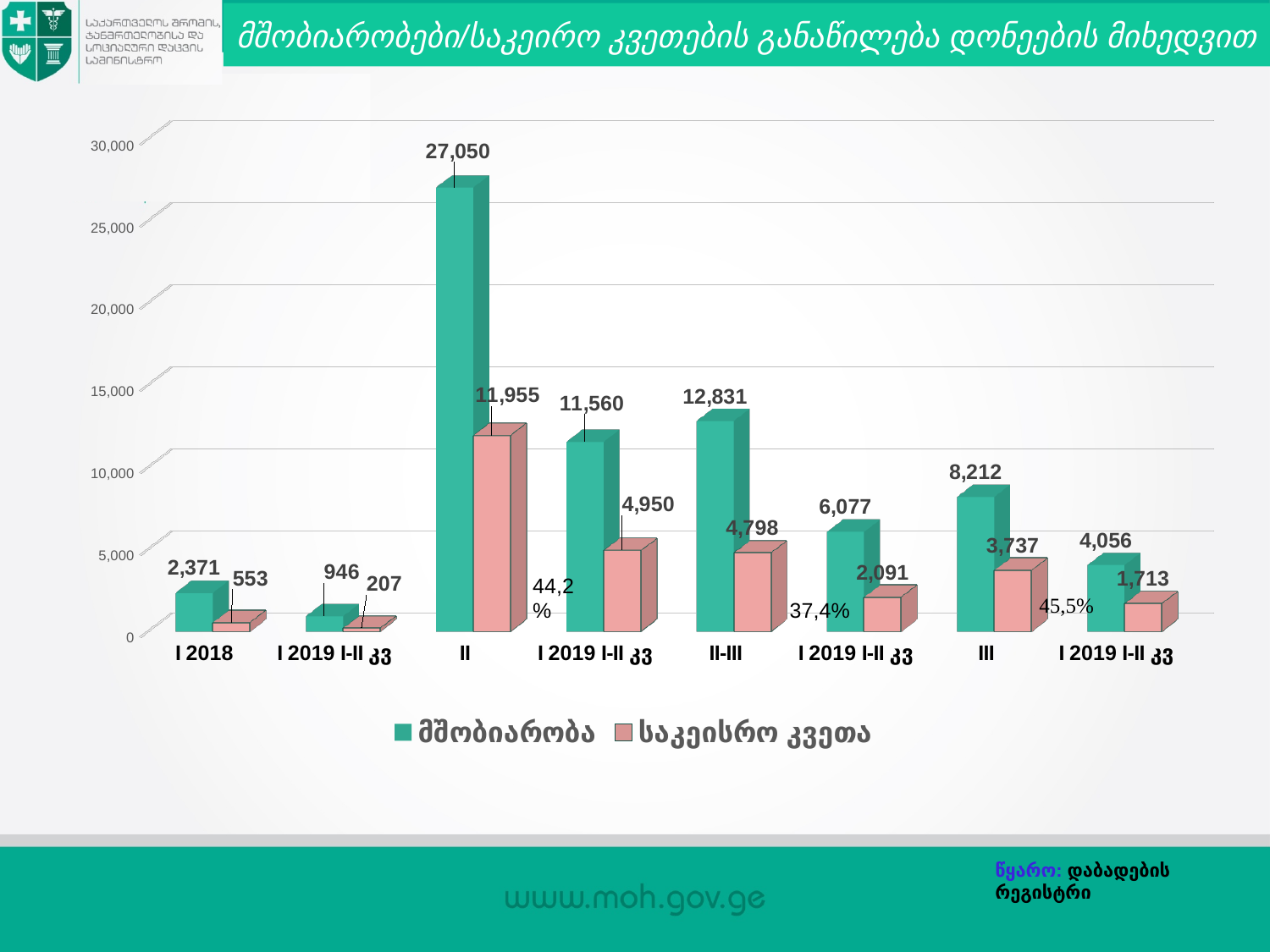
What is the value of მშობიარობა for the II category? 27,050 Which is larger: მშობიარობა for II-III or მშობიარობა for III? II-III What is the value of საკეისრო კვეთა for the III category? 3,737 How many categories are shown on the x axis? 8 What is the difference between მშობიარობა and საკეისრო კვეთა for the I 2018 category? 1,818 Is the value of მშობიარობა for the II category greater or less than 25,000? greater Which category has the highest value for მშობიარობა? II What is the difference between მშობიარობა and საკეისრო კვეთა for the II category? 15,095 What is the value of საკეისრო კვეთა for the II-III category? 4,798 Which category has the lowest value for საკეისრო კვეთა? I 2019 I-II კვ (second category from the left, 207) How many series does the legend list? 2 What kind of chart is shown on the slide? bar chart